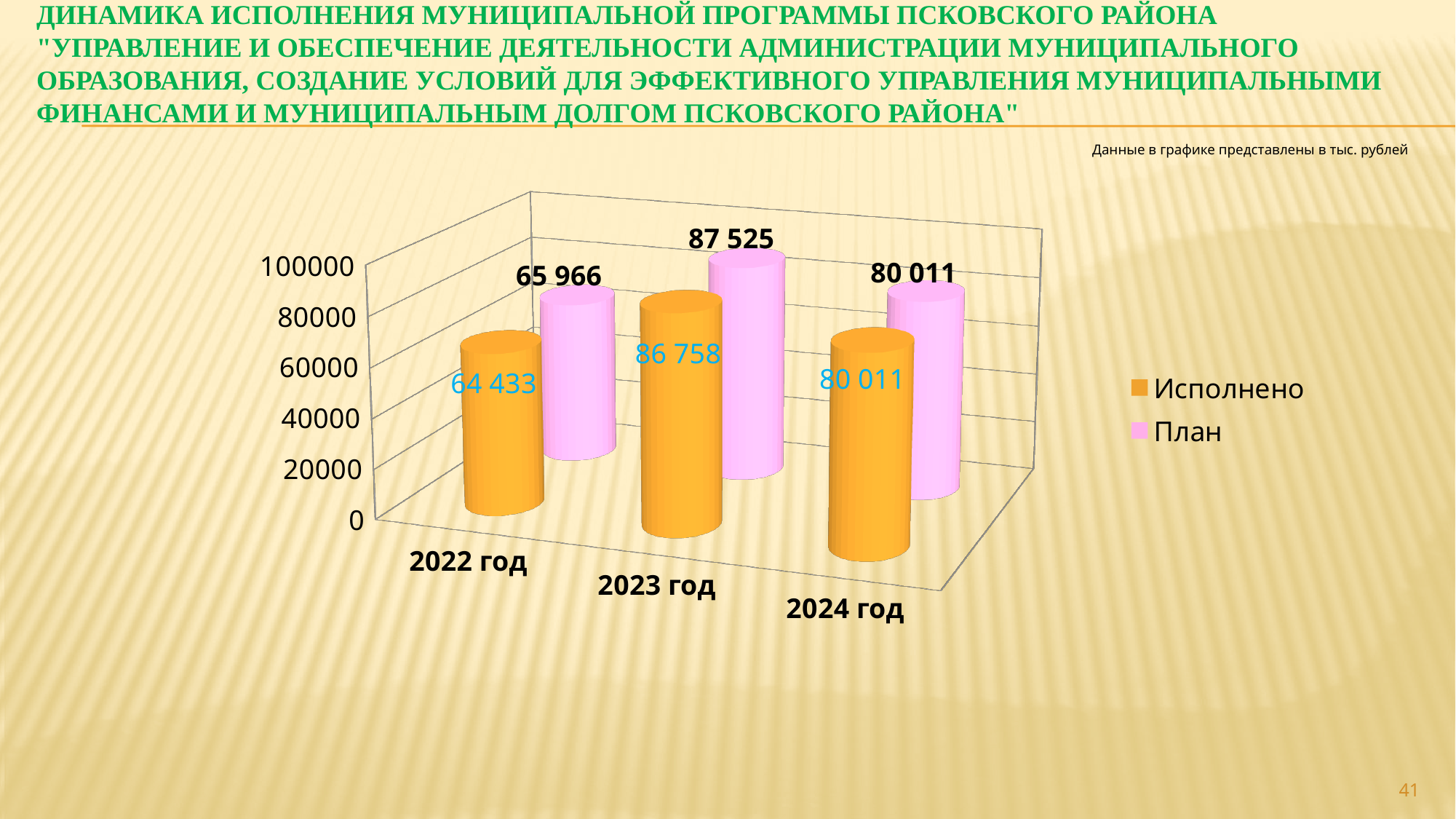
In which year is the Исполнено value highest? 2023 год Is the Исполнено value for 2023 год greater or less than 80000? greater What is the value of План for 2022 год? 65 966 What is the value of План for 2024 год? 80 011 What kind of chart is shown on the slide? Bar chart What is the difference between План and Исполнено for 2023 год? 767 What is the value of Исполнено for 2023 год? 86 758 How many series does the legend list? 2 How many years are shown on the x axis? 3 In which year is the Исполнено value lowest? 2022 год What is the difference between План and Исполнено for 2022 год? 1 533